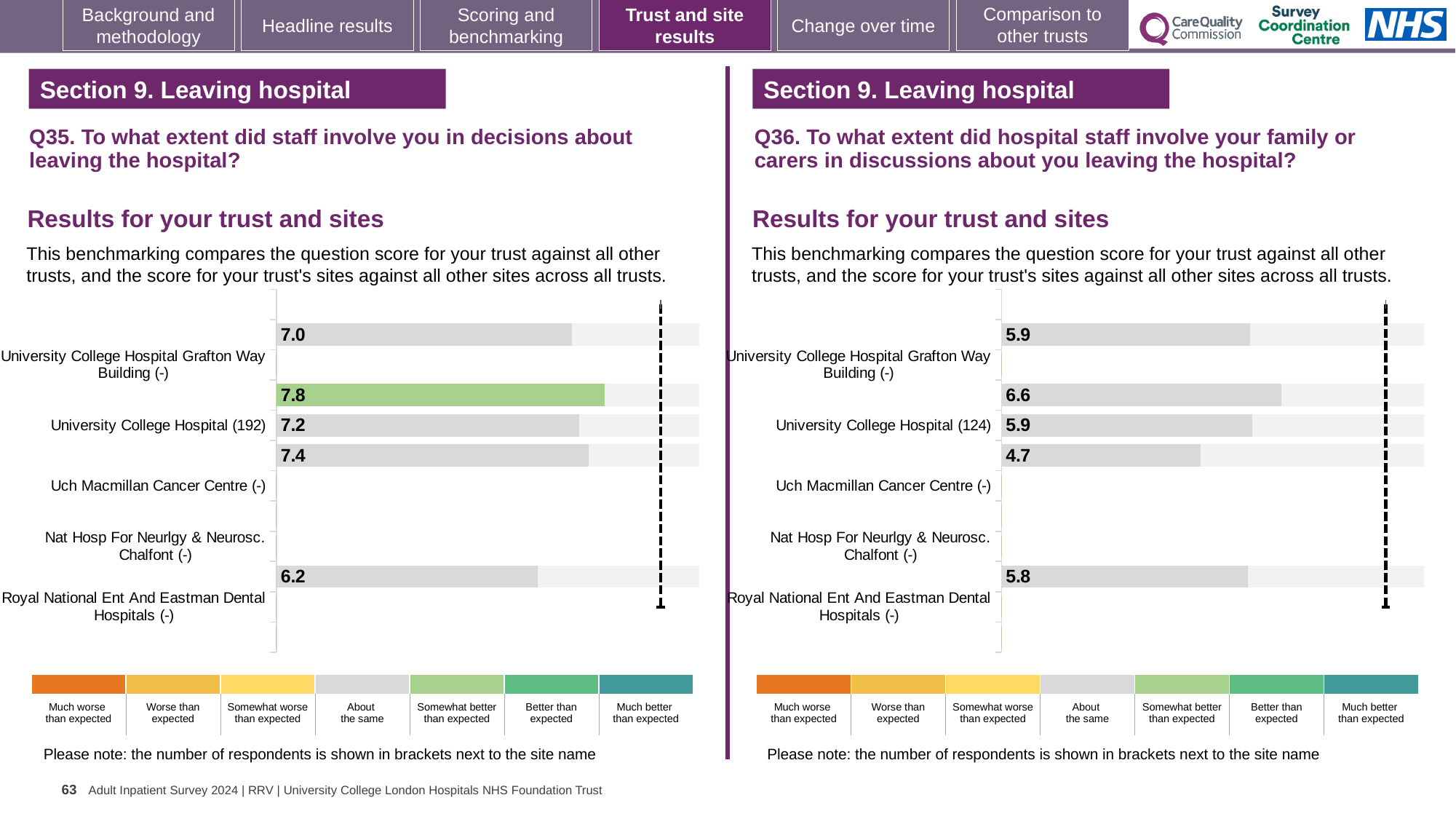
On the Q36 chart, what is the difference between the highest and lowest scores shown? 1.9 What kind of chart is used on the left (Q35) side of the slide? bar chart On the Q36 chart, what is the lowest score shown? 4.7 On the Q36 chart, what is the highest score shown? 6.6 On the Q35 chart, what is the score for University College Hospital (192)? 7.2 Which chart has the higher top score, the Q35 chart or the Q36 chart? Q35 chart How many bars are plotted on the Q35 chart? 5 On the Q36 chart, what is the score for University College Hospital (124)? 5.9 On the Q35 chart, what is the highest score shown? 7.8 On the Q35 chart, what is the lowest score shown? 6.2 On the Q35 chart, what value is labelled on the green bar? 7.8 On the Q35 chart, what is the difference between the highest and lowest scores shown? 1.6